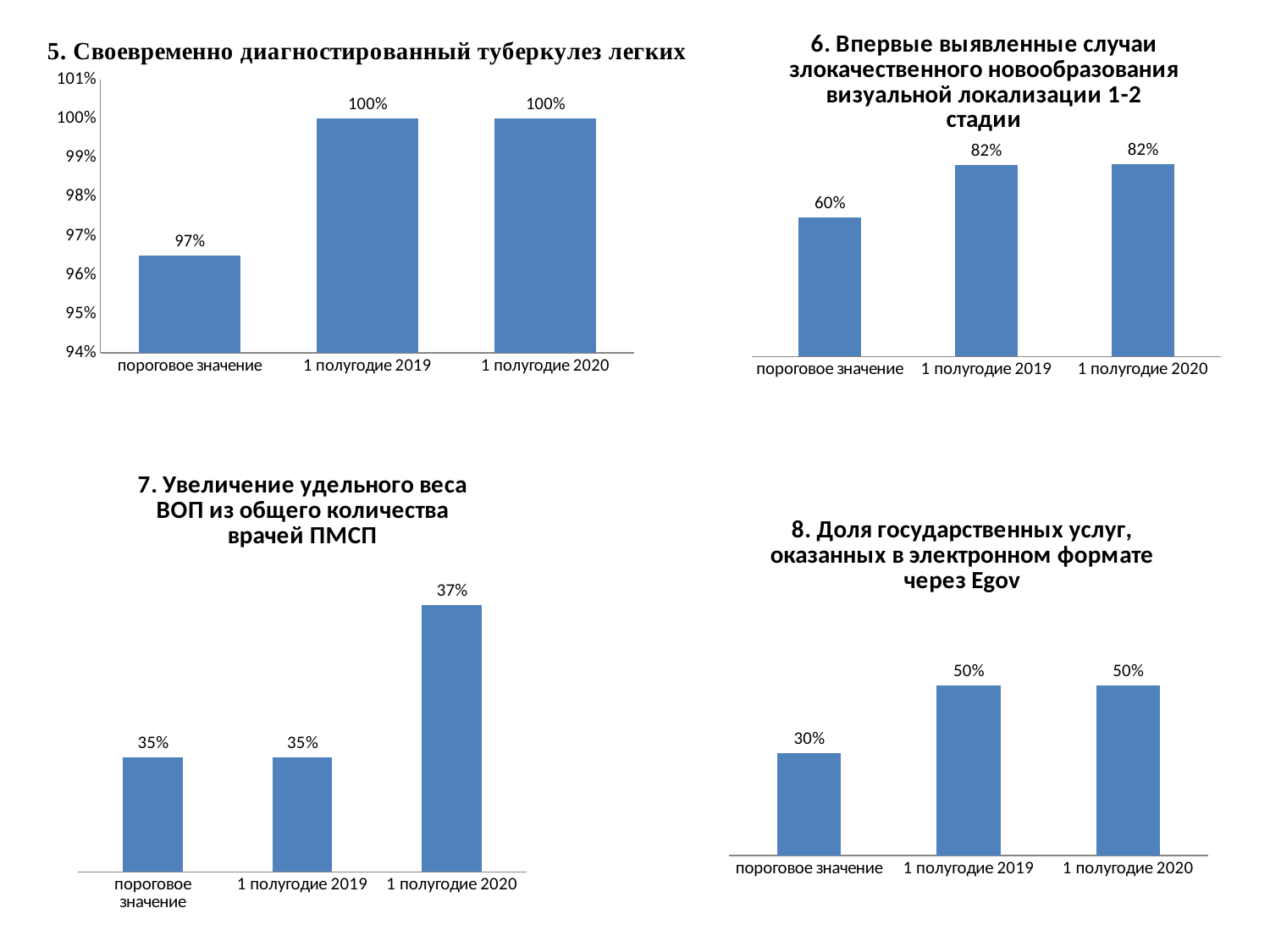
In the chart titled "8. Доля государственных услуг, оказанных в электронном формате через Egov", what is the value for "1 полугодие 2019"? 50% In the chart titled "6. Впервые выявленные случаи злокачественного новообразования визуальной локализации 1-2 стадии", what is the difference between the value for "1 полугодие 2019" and the value for "пороговое значение"? 22% In the chart titled "7. Увеличение удельного веса ВОП из общего количества врачей ПМСП", which category has the highest value? 1 полугодие 2020 In the chart titled "8. Доля государственных услуг, оказанных в электронном формате через Egov", which category has the lowest value? пороговое значение How many categories are shown in the chart titled "6. Впервые выявленные случаи злокачественного новообразования визуальной локализации 1-2 стадии"? 3 What type of chart is the chart titled "7. Увеличение удельного веса ВОП из общего количества врачей ПМСП"? bar chart In the chart titled "7. Увеличение удельного веса ВОП из общего количества врачей ПМСП", what is the value for "1 полугодие 2020"? 37% In the chart titled "5. Своевременно диагностированный туберкулез легких", what is the value for "пороговое значение"? 97% In the chart titled "8. Доля государственных услуг, оказанных в электронном формате через Egov", is the value for "1 полугодие 2020" larger or smaller than the value for "пороговое значение"? larger In the chart titled "5. Своевременно диагностированный туберкулез легких", what is the value for "1 полугодие 2020"? 100% In the chart titled "6. Впервые выявленные случаи злокачественного новообразования визуальной локализации 1-2 стадии", what is the value for "пороговое значение"? 60% How many charts are shown on the slide? 4